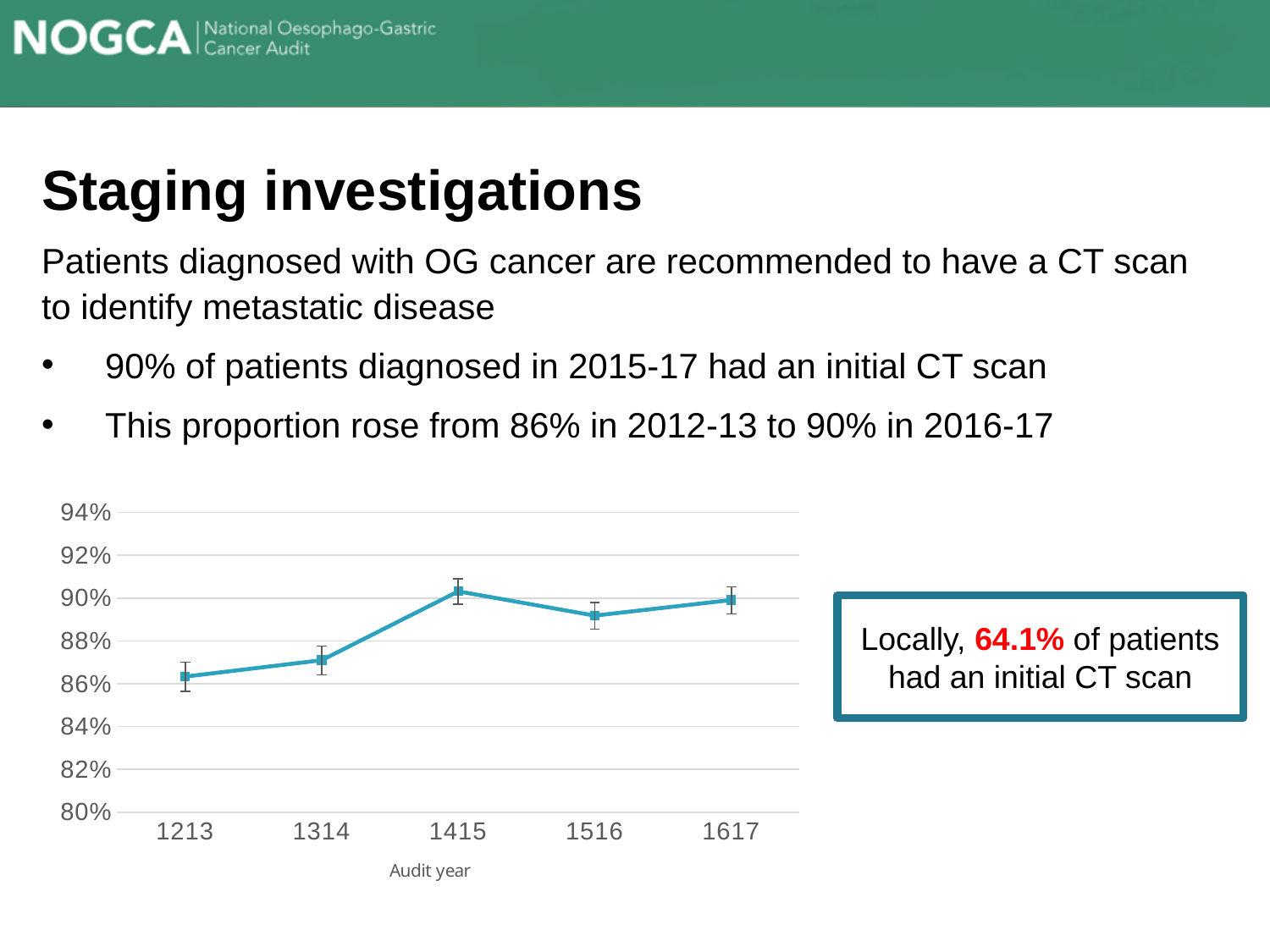
How many audit years are plotted on the x axis of the chart? 5 Is the value for 1314 greater or less than 88%? less Which has the larger value, 1213 or 1415? 1415 Which has the larger value, 1314 or 1617? 1617 Is the value for 1516 greater or less than 90%? less Which audit year has the lowest value on the chart? 1213 Is the value for 1617 greater or less than 88%? greater What kind of chart is shown on the slide? line chart What is the title of the x axis of the chart? Audit year Overall, do the values rise or fall from 1213 to 1617 along the x axis? rise